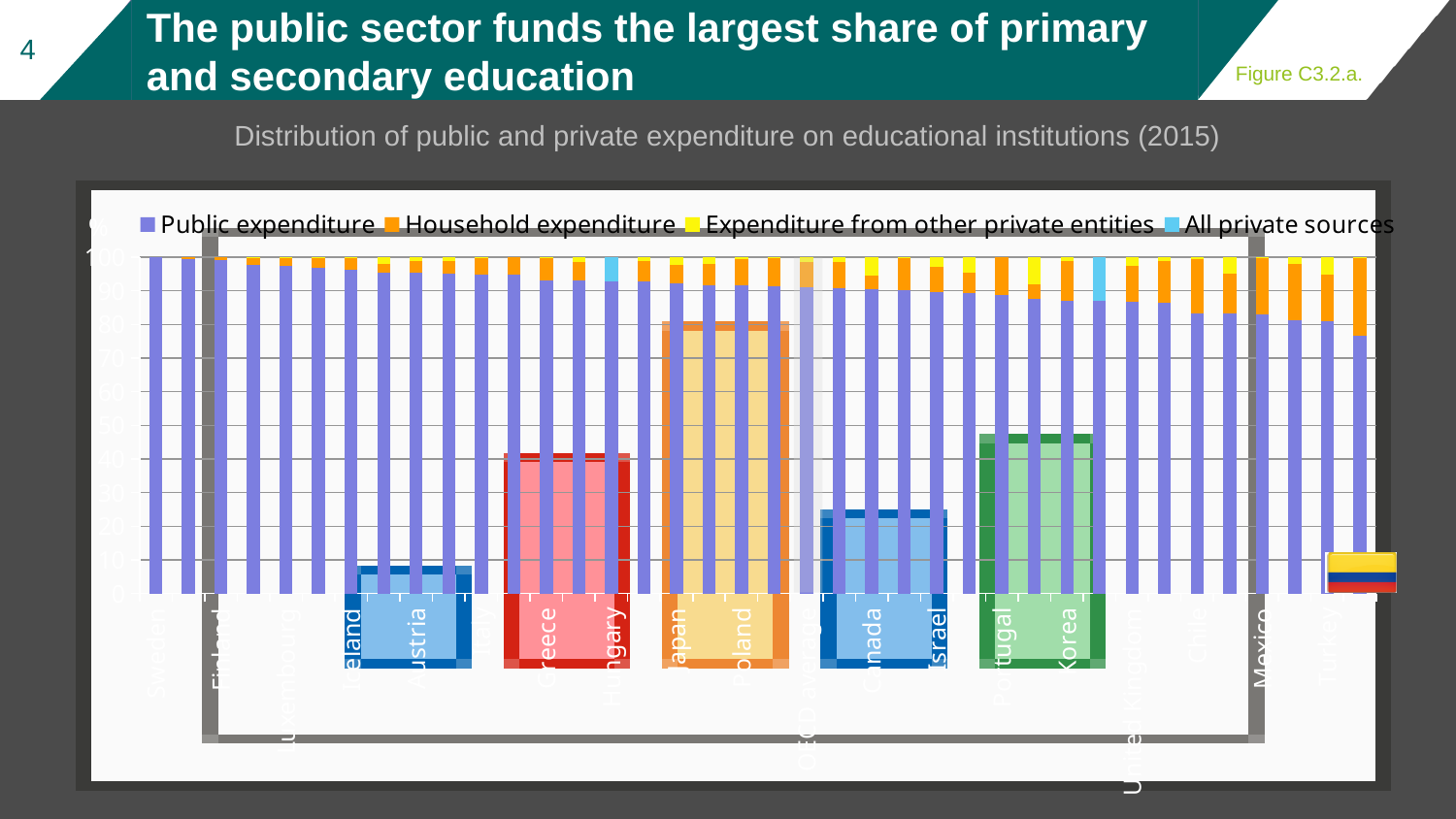
What is the title of the chart? Distribution of public and private expenditure on educational institutions (2015) Do the public expenditure values generally rise or fall from left to right along the x axis? Fall Which has a larger public expenditure share, Sweden or Turkey? Sweden Is the public expenditure value for Turkey greater or less than 90? less Is the public expenditure value for Korea greater or less than 80? greater Which series is shown in orange in the chart legend? Household expenditure What kind of chart is shown on the slide? Stacked bar chart How many series does the chart legend list? 4 Is the public expenditure value for Sweden greater or less than 90? greater